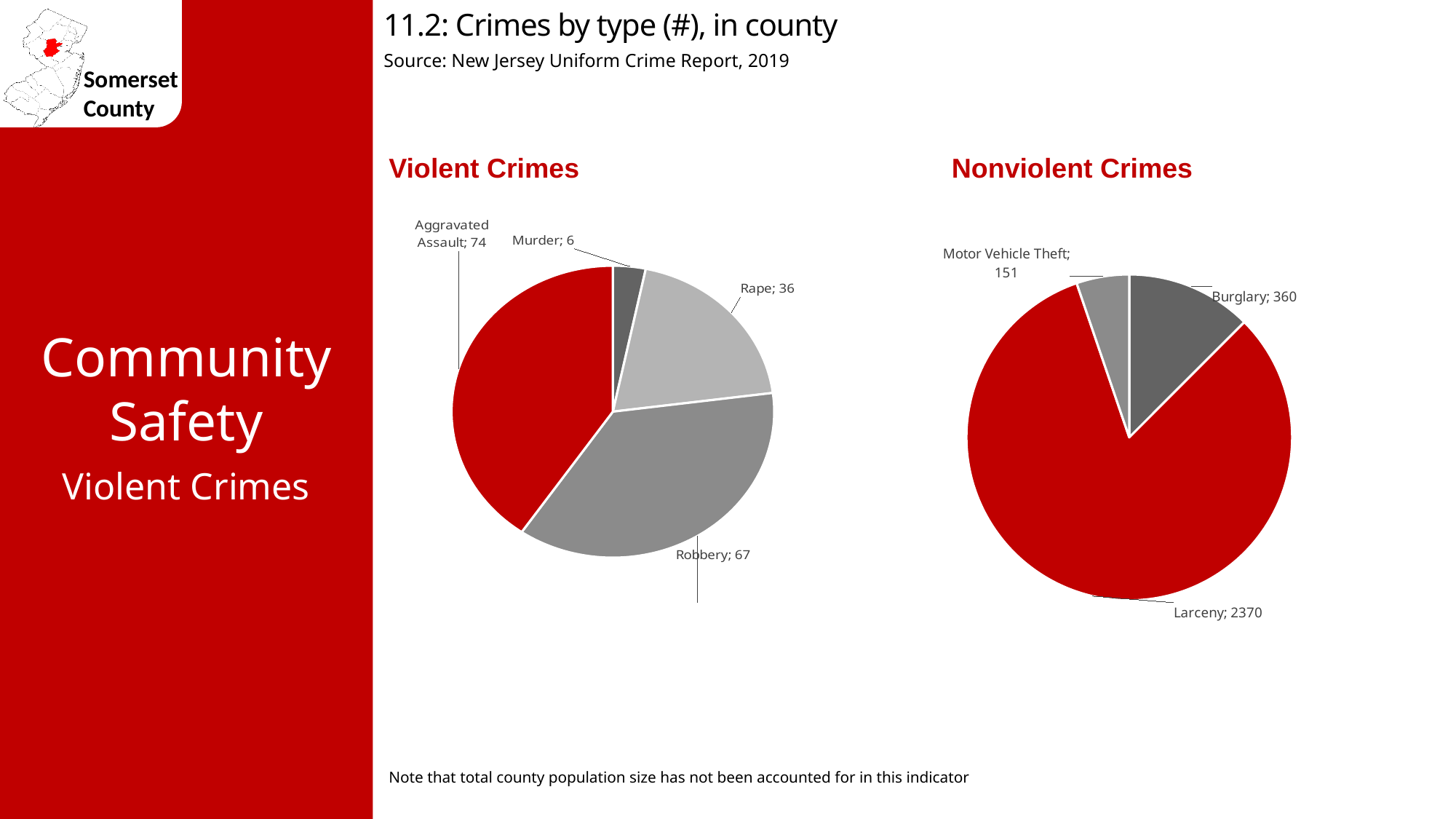
In the Violent Crimes chart, which crime type has the smallest value? Murder In the Nonviolent Crimes chart, which crime type has the smallest value? Motor Vehicle Theft In the Nonviolent Crimes chart, what is the difference between Burglary and Motor Vehicle Theft? 209 What kind of chart is used for Violent Crimes? Pie chart In the Nonviolent Crimes chart, what is the value for Larceny? 2370 In the Violent Crimes chart, which crime type has the largest value? Aggravated Assault In the Violent Crimes chart, what is the difference between Aggravated Assault and Robbery? 7 How many crime types are shown in the Nonviolent Crimes chart? 3 In the Violent Crimes chart, which is larger, Rape or Robbery? Robbery In the Violent Crimes chart, what is the value for Murder? 6 In the Violent Crimes chart, how many aggravated assaults are shown? 74 In the Nonviolent Crimes chart, what is the value for Motor Vehicle Theft? 151